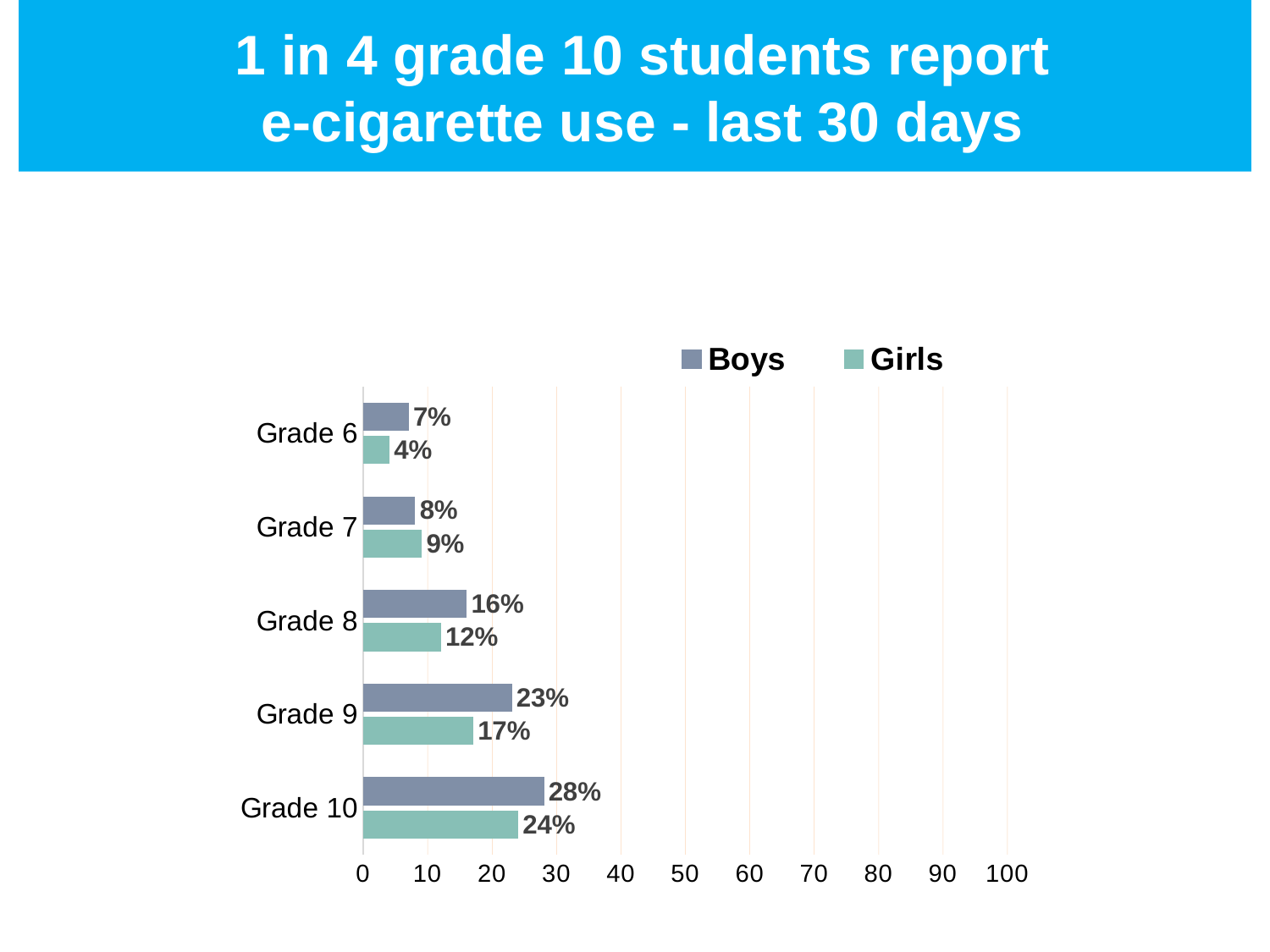
How many series does the legend list? 2 What kind of chart is shown on the slide? Bar chart Which grade has the highest value for Girls? Grade 10 Is the value for Grade 10 boys greater or less than 20? greater What is the difference between the Boys and Girls values for Grade 9? 6% What is the value for Boys in Grade 7? 8% How many grade categories are shown on the chart? 5 Do the Boys values rise or fall from Grade 6 to Grade 10? Rise Which is larger in Grade 7, the Boys value or the Girls value? Girls What percentage of Grade 10 boys report e-cigarette use in the last 30 days? 28% Which grade has the lowest value for Boys? Grade 6 What is the value for Girls in Grade 8? 12%